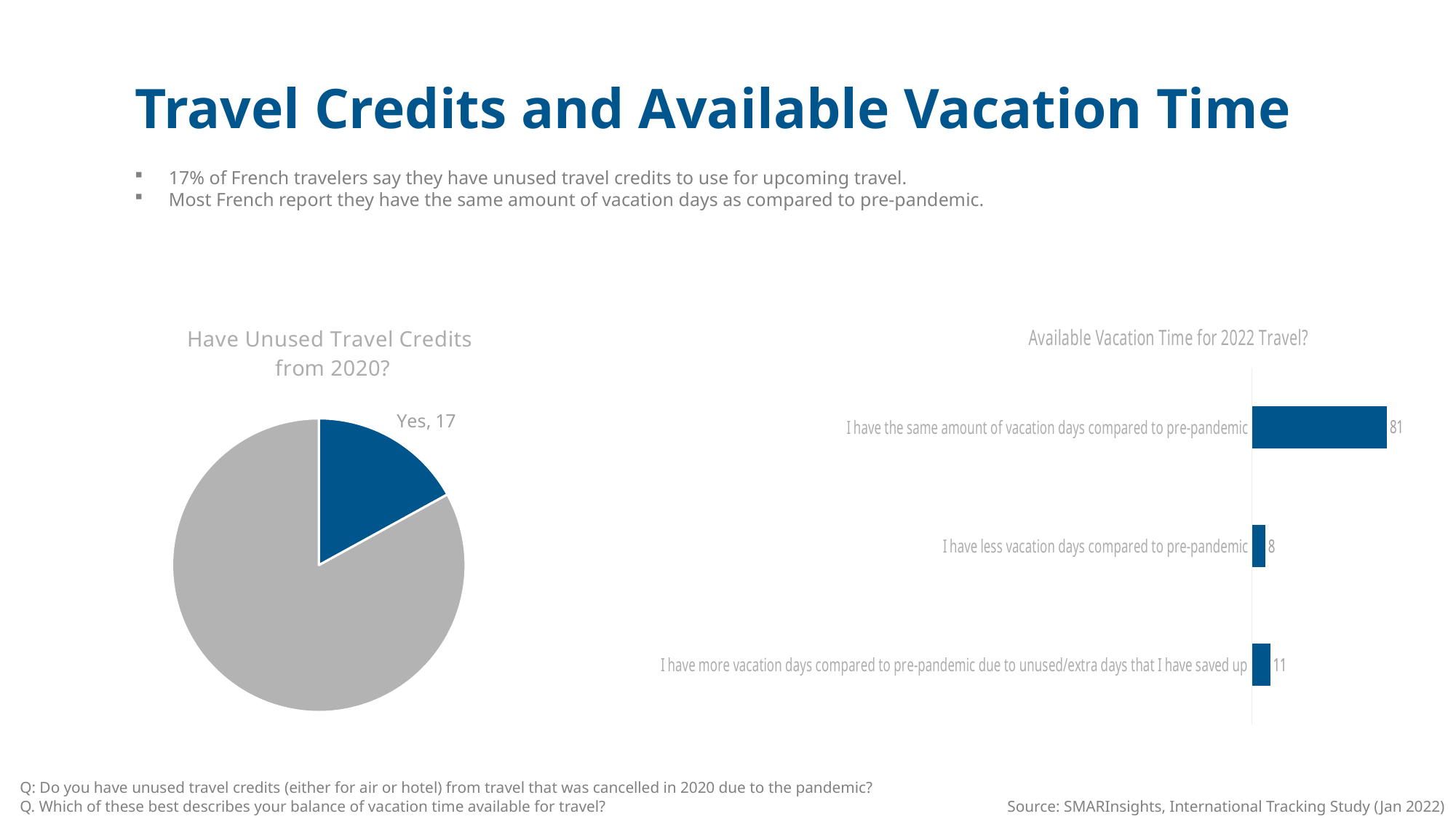
What is the title of the pie chart on the left of the slide? Have Unused Travel Credits from 2020? In the 'Available Vacation Time for 2022 Travel?' chart, which category has the highest value? I have the same amount of vacation days compared to pre-pandemic In the 'Available Vacation Time for 2022 Travel?' chart, which category has the lowest value? I have less vacation days compared to pre-pandemic In the 'Available Vacation Time for 2022 Travel?' chart, which is larger: the value for 'I have less vacation days compared to pre-pandemic' or the value for 'I have more vacation days compared to pre-pandemic due to unused/extra days that I have saved up'? I have more vacation days compared to pre-pandemic due to unused/extra days that I have saved up In the 'Available Vacation Time for 2022 Travel?' chart, what is the value for 'I have more vacation days compared to pre-pandemic due to unused/extra days that I have saved up'? 11 In the 'Available Vacation Time for 2022 Travel?' chart, what is the value for 'I have the same amount of vacation days compared to pre-pandemic'? 81 In the 'Have Unused Travel Credits from 2020?' chart, what value is shown for the 'Yes' slice? 17 How many categories are shown in the 'Available Vacation Time for 2022 Travel?' chart? 3 What kind of chart is 'Available Vacation Time for 2022 Travel?'? bar chart In the 'Available Vacation Time for 2022 Travel?' chart, what is the difference between the value for 'I have the same amount of vacation days compared to pre-pandemic' and the value for 'I have more vacation days compared to pre-pandemic due to unused/extra days that I have saved up'? 70 In the 'Available Vacation Time for 2022 Travel?' chart, what is the value for 'I have less vacation days compared to pre-pandemic'? 8 What kind of chart is 'Have Unused Travel Credits from 2020?'? pie chart